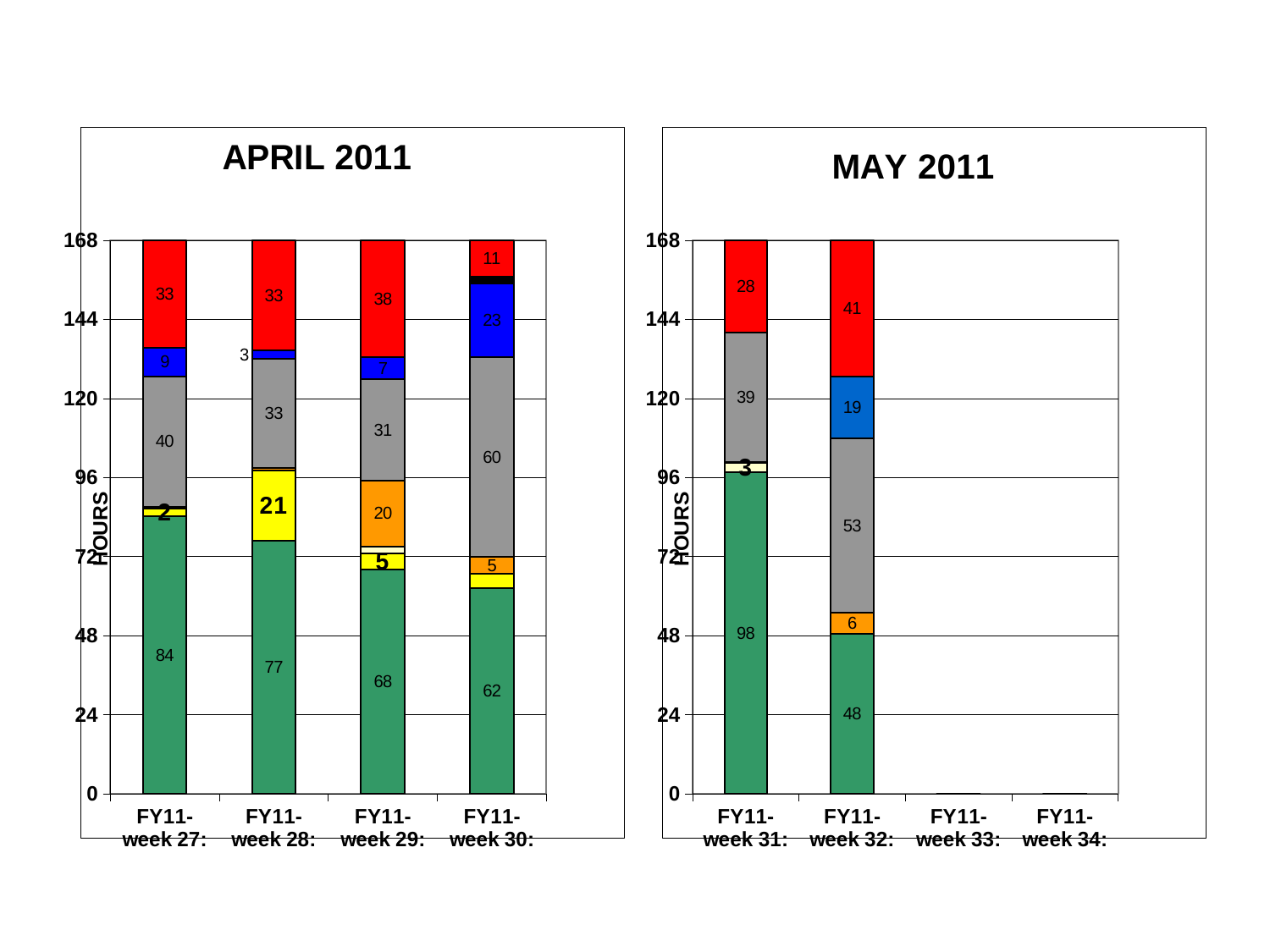
In the APRIL 2011 chart, what is the value of the green segment for FY11-week 27? 84 In the APRIL 2011 chart, what is the difference between the red segment for FY11-week 29 and the red segment for FY11-week 27? 5 In the APRIL 2011 chart, does the green segment rise or fall from FY11-week 27 to FY11-week 30? fall In the MAY 2011 chart, what is the value of the green segment for FY11-week 31? 98 How many week categories are shown on the x axis of the MAY 2011 chart? 4 In the APRIL 2011 chart, what is the total of the stacked bar for FY11-week 27? 168 In the APRIL 2011 chart, what is the value of the red segment for FY11-week 29? 38 In the MAY 2011 chart, which is larger: the green segment for FY11-week 31 or the green segment for FY11-week 32? FY11-week 31 What kind of chart is the APRIL 2011 chart? stacked bar chart In the MAY 2011 chart, what is the value of the gray segment for FY11-week 32? 53 In the APRIL 2011 chart, which week has the smallest red segment? FY11-week 30 In the APRIL 2011 chart, which week has the largest green segment? FY11-week 27